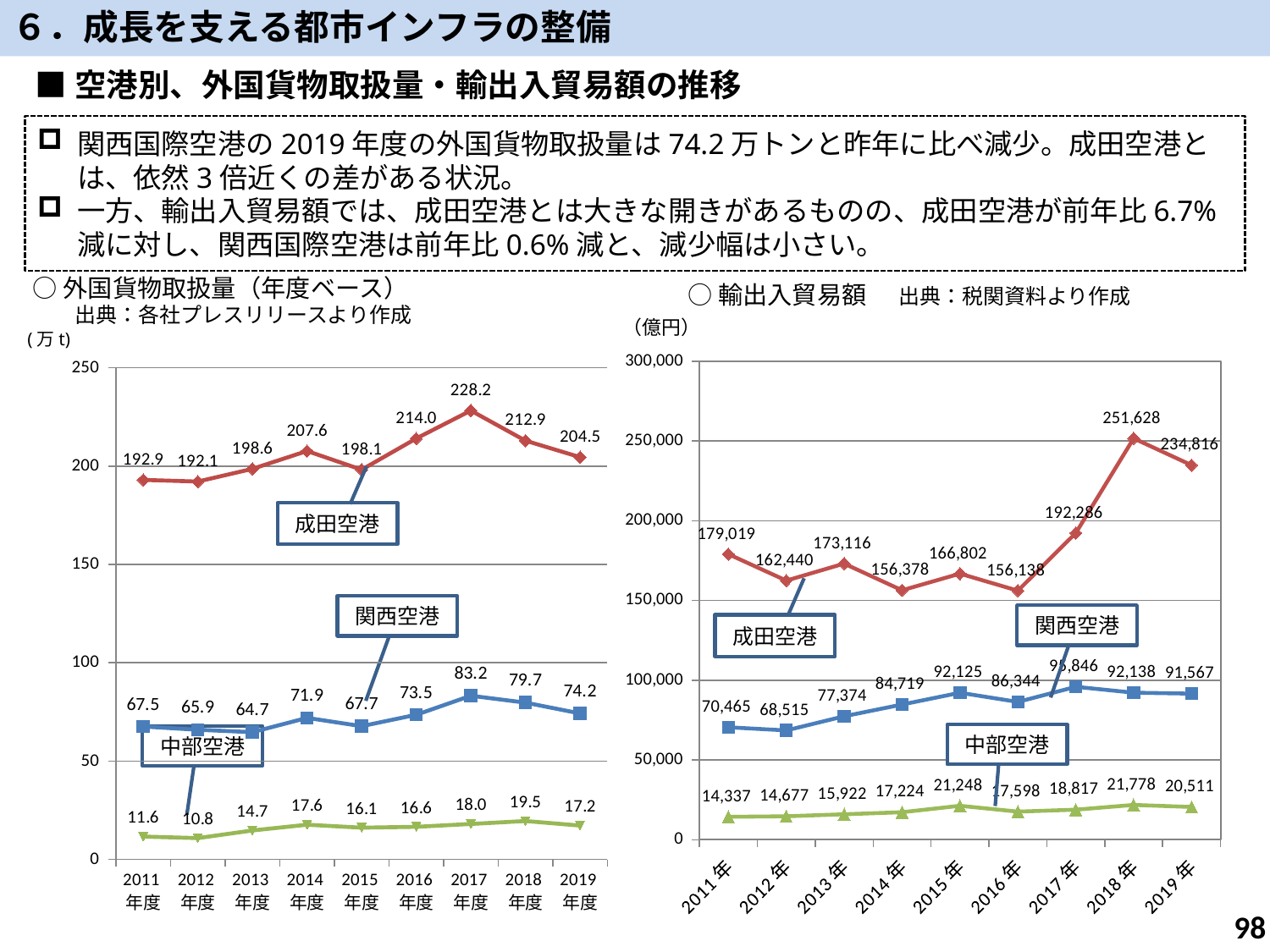
In the left chart (外国貨物取扱量), what is the value for 成田空港 in 2017年度? 228.2 In the left chart (外国貨物取扱量), what is the value for 関西空港 in 2019年度? 74.2 In the right chart (輸出入貿易額), what is the value for 成田空港 in 2018年? 251,628 In the left chart (外国貨物取扱量), in which year is the value for 関西空港 lowest? 2013年度 In the left chart (外国貨物取扱量), what is the difference between 成田空港 and 関西空港 in 2019年度? 130.3 In the right chart (輸出入貿易額), is the value for 成田空港 in 2019年 greater or less than 200,000? greater In the left chart (外国貨物取扱量), how many fiscal years are shown on the x axis? 9 What type of chart is the left chart (外国貨物取扱量)? Line chart In the right chart (輸出入貿易額), which is larger: 関西空港 in 2018年 or 関西空港 in 2019年? 2018年 In the right chart (輸出入貿易額), what is the value for 中部空港 in 2015年? 21,248 In the right chart (輸出入貿易額), in which year is the value for 関西空港 highest? 2017年 In the left chart (外国貨物取扱量), in which year does 中部空港 reach its highest value? 2018年度